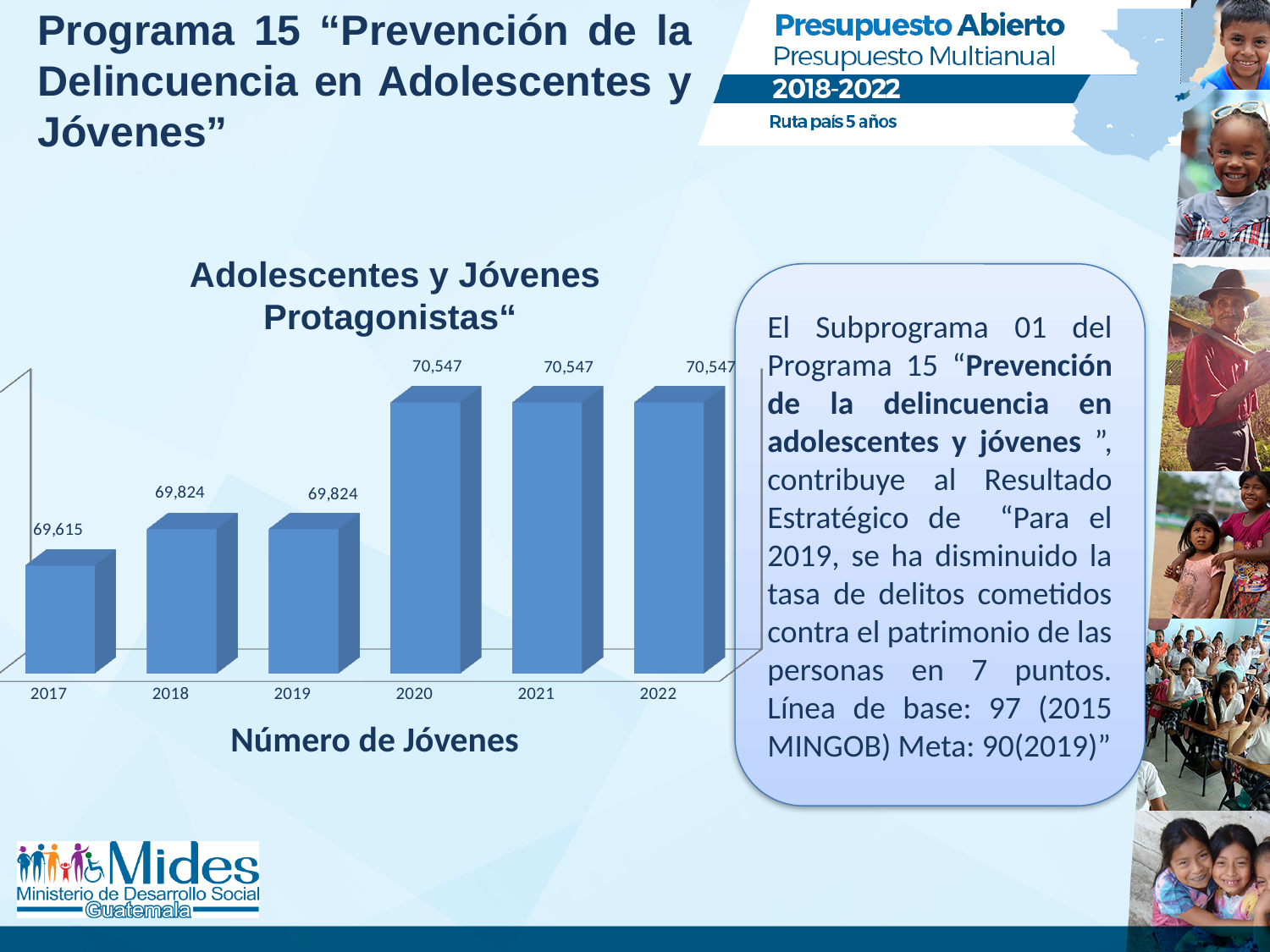
What is the difference between the values for 2020 and 2017? 932 How many years are shown on the x axis of the chart? 6 What is the title of the chart? Adolescentes y Jóvenes Protagonistas What label appears below the x axis of the chart? Número de Jóvenes What kind of chart is shown on the slide? bar chart What is the value for 2021 in the chart? 70,547 What is the value for 2019 in the chart? 69,824 What is the value for 2017 in the chart? 69,615 Which is larger, the value for 2019 or the value for 2020? 2020 Do the values in the chart rise or fall from 2017 to 2022? rise What is the difference between the values for 2018 and 2017? 209 Which year has the lowest value in the chart? 2017